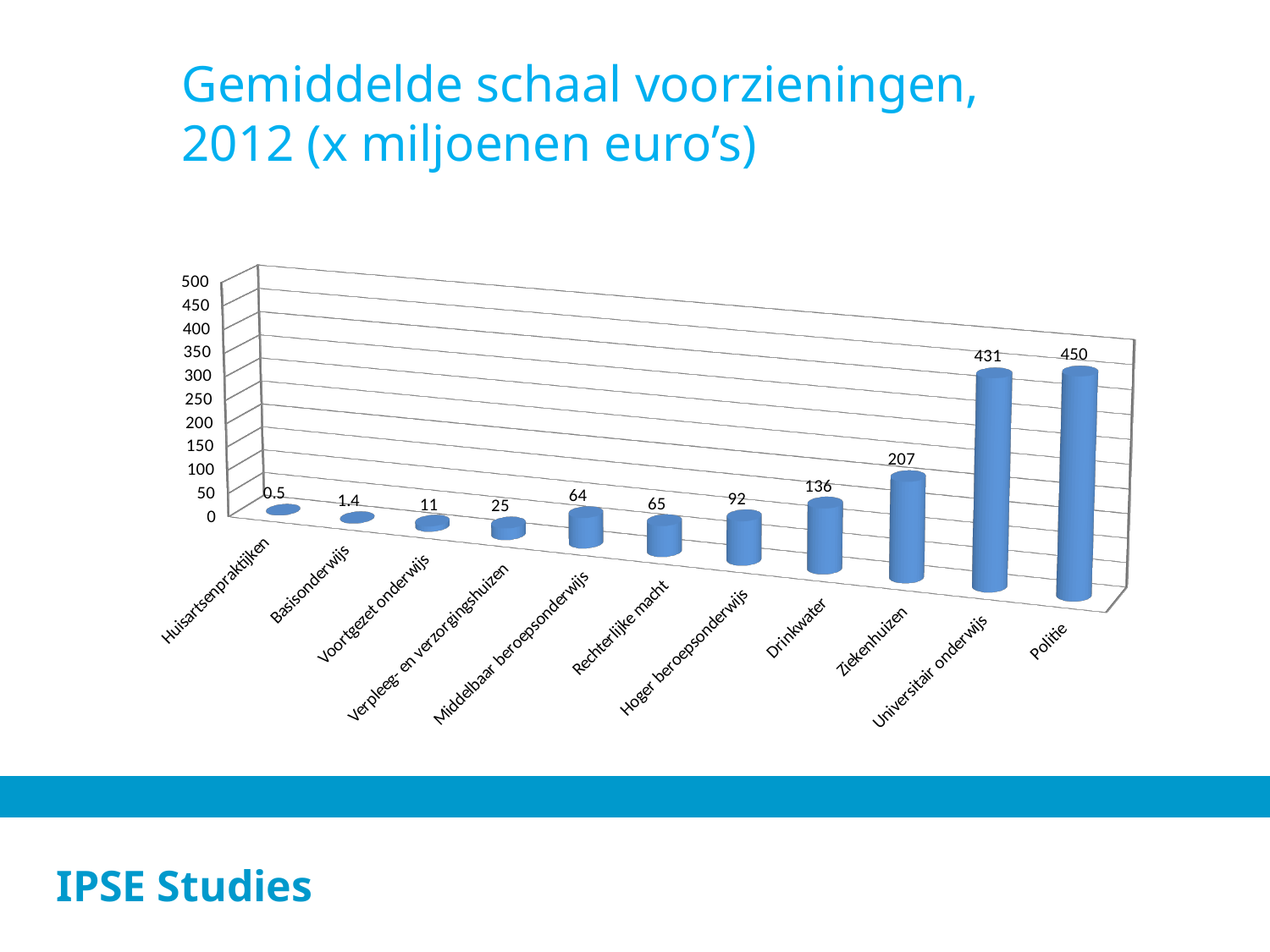
What is the value for Politie? 450 Which is larger, the value for Hoger beroepsonderwijs or the value for Drinkwater? Drinkwater Which category has the lowest value? Huisartsenpraktijken Which category has the highest value? Politie What is the title of the slide? Gemiddelde schaal voorzieningen, 2012 (x miljoenen euro's) What is the value for Huisartsenpraktijken? 0.5 What is the difference between the values for Politie and Universitair onderwijs? 19 What kind of chart is shown on the slide? Bar chart How many categories are shown in the chart? 11 What is the value for Ziekenhuizen? 207 Do the values rise or fall from left to right along the x axis? Rise What is the value for Drinkwater? 136